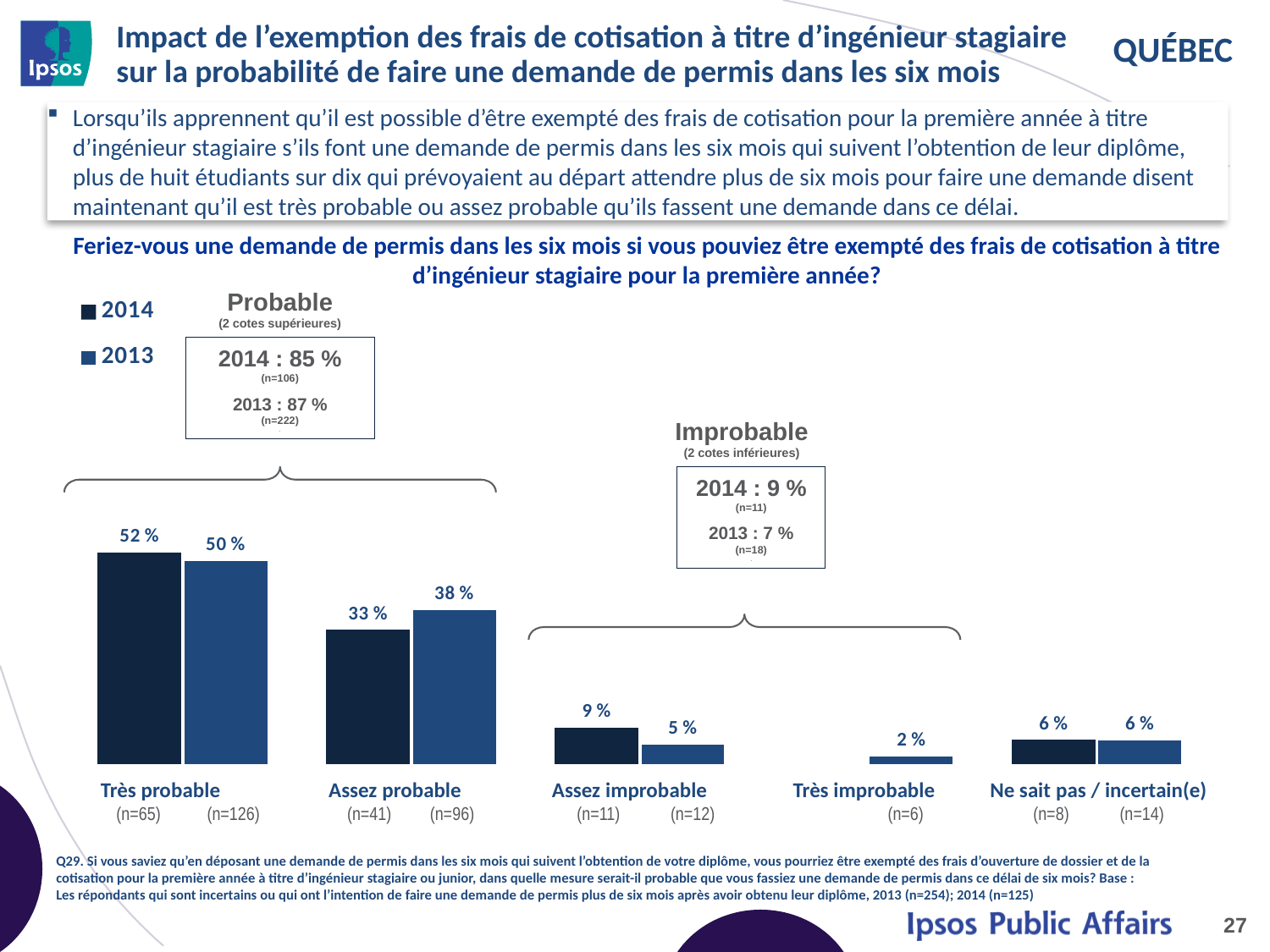
Which category has the lowest 2013 value? Très improbable What is the 2014 value for "Assez improbable"? 9 % How many categories are shown on the x axis of the chart? 5 What is the combined "Probable" (2 cotes supérieures) value shown for 2014? 85 % What is the difference between the 2013 and 2014 values for "Assez probable"? 5 % Which is larger for "Assez improbable": the 2014 value or the 2013 value? 2014 What kind of chart is shown on the slide? bar chart How many series does the chart legend list? 2 What is the 2014 value for "Très probable"? 52 % Which category has the highest 2014 value? Très probable What is the 2013 value for "Assez probable"? 38 % What is the 2013 value for "Très improbable"? 2 %